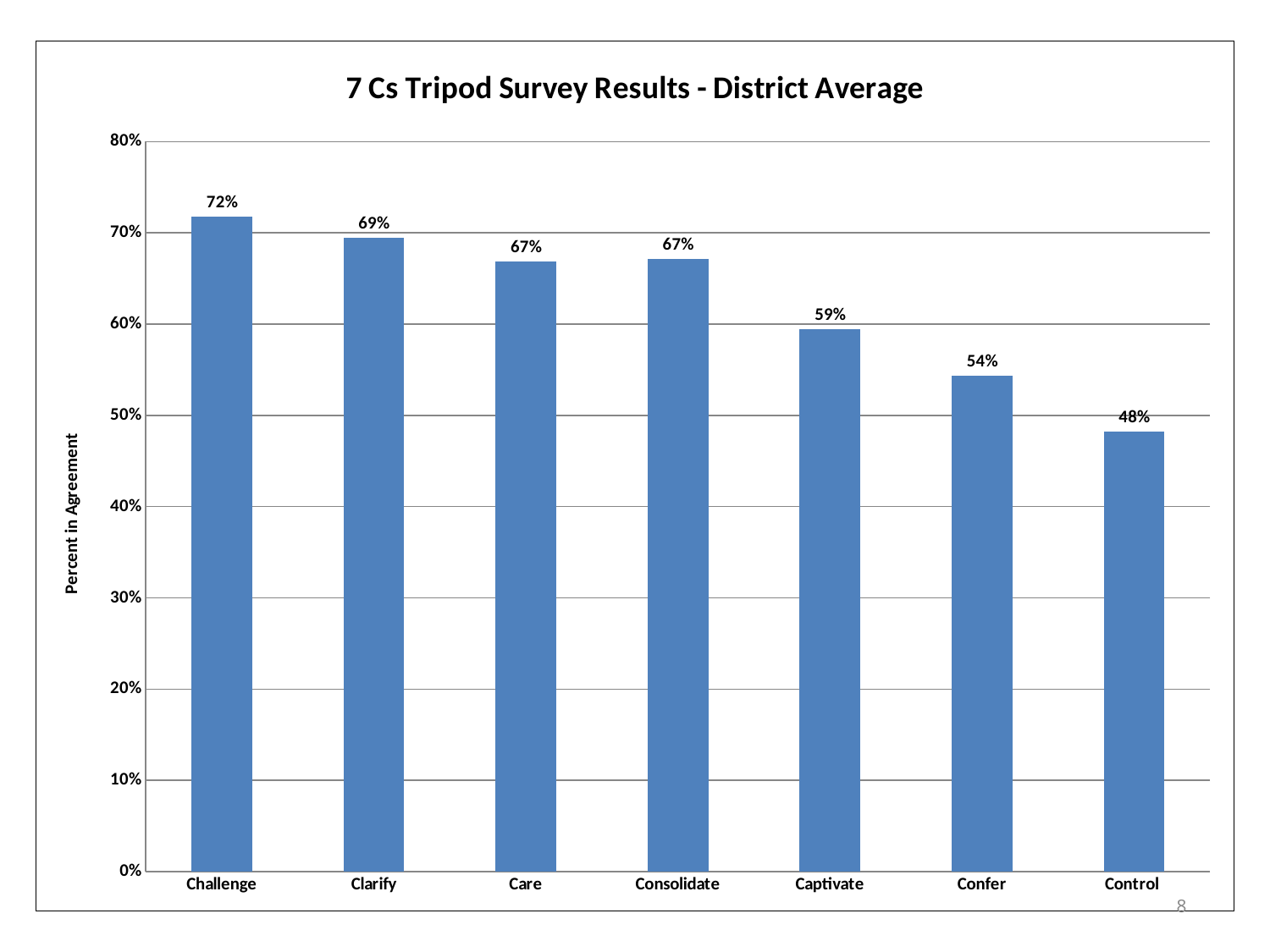
Which category has the highest value? Challenge What is the value for Challenge? 72% How many categories are shown on the x axis? 7 What kind of chart is shown on the slide? bar chart Is the value for Control greater or less than 50%? less What is the difference between the values for Clarify and Confer? 15% Which category has the lowest value? Control What is the value for Captivate? 59% What is the value for Confer? 54% What is the difference between the values for Challenge and Control? 24% What is the title of the chart? 7 Cs Tripod Survey Results - District Average Which is larger, the value for Clarify or the value for Captivate? Clarify